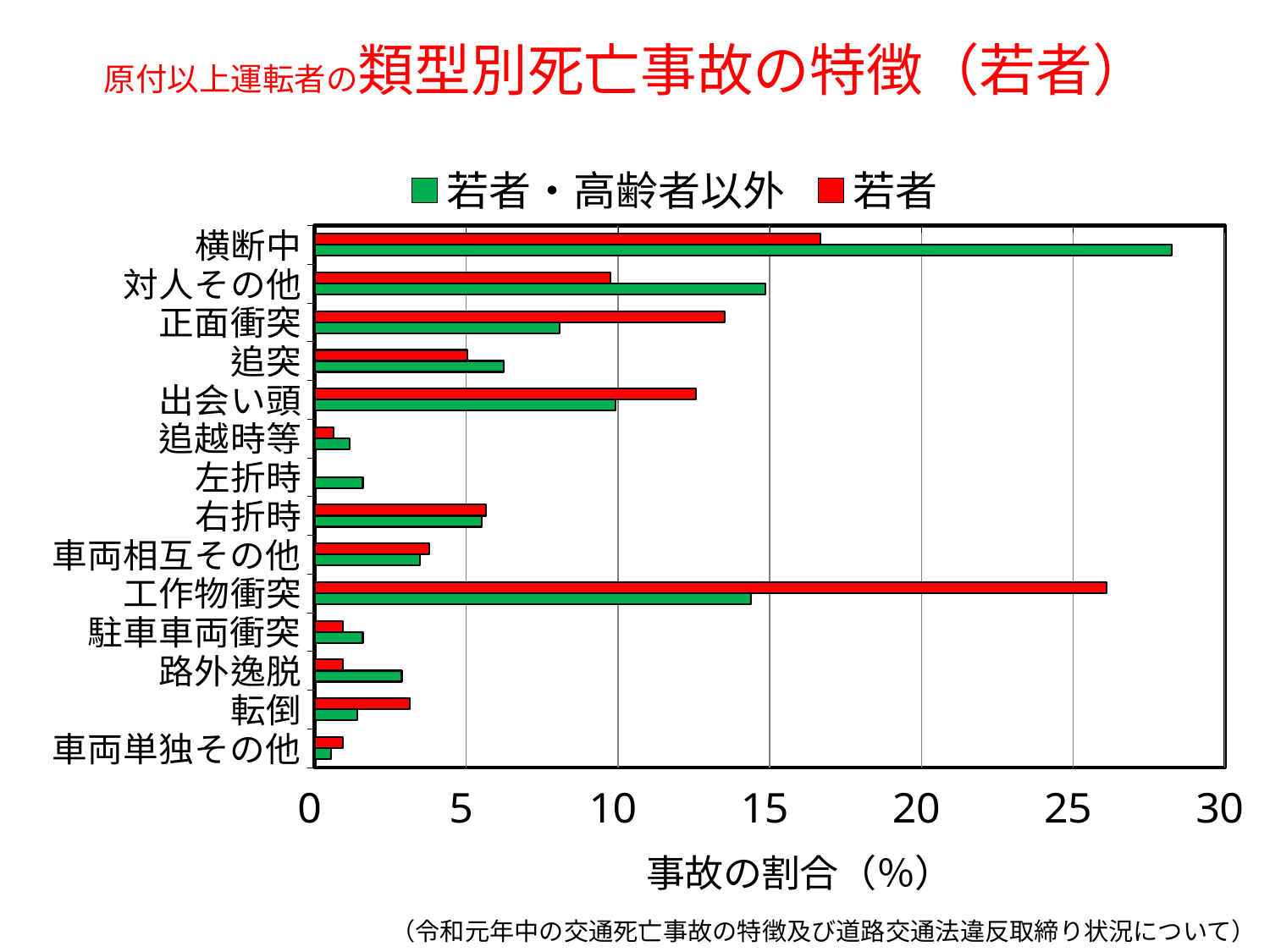
Is the 若者 value for 正面衝突 greater or less than 10? greater Which category has the lowest value for the 若者・高齢者以外 series? 車両単独その他 For 出会い頭, which series has the larger value, 若者 or 若者・高齢者以外? 若者 Is the 若者・高齢者以外 value for 正面衝突 greater or less than 10? less How many series does the legend list? 2 Which category has the highest value for the 若者 series? 工作物衝突 What is the label of the horizontal axis? 事故の割合（%） Is the 若者 value for 工作物衝突 greater or less than 25? greater Which category has the highest value for the 若者・高齢者以外 series? 横断中 What kind of chart is shown on the slide? bar chart How many accident categories are plotted on the chart? 14